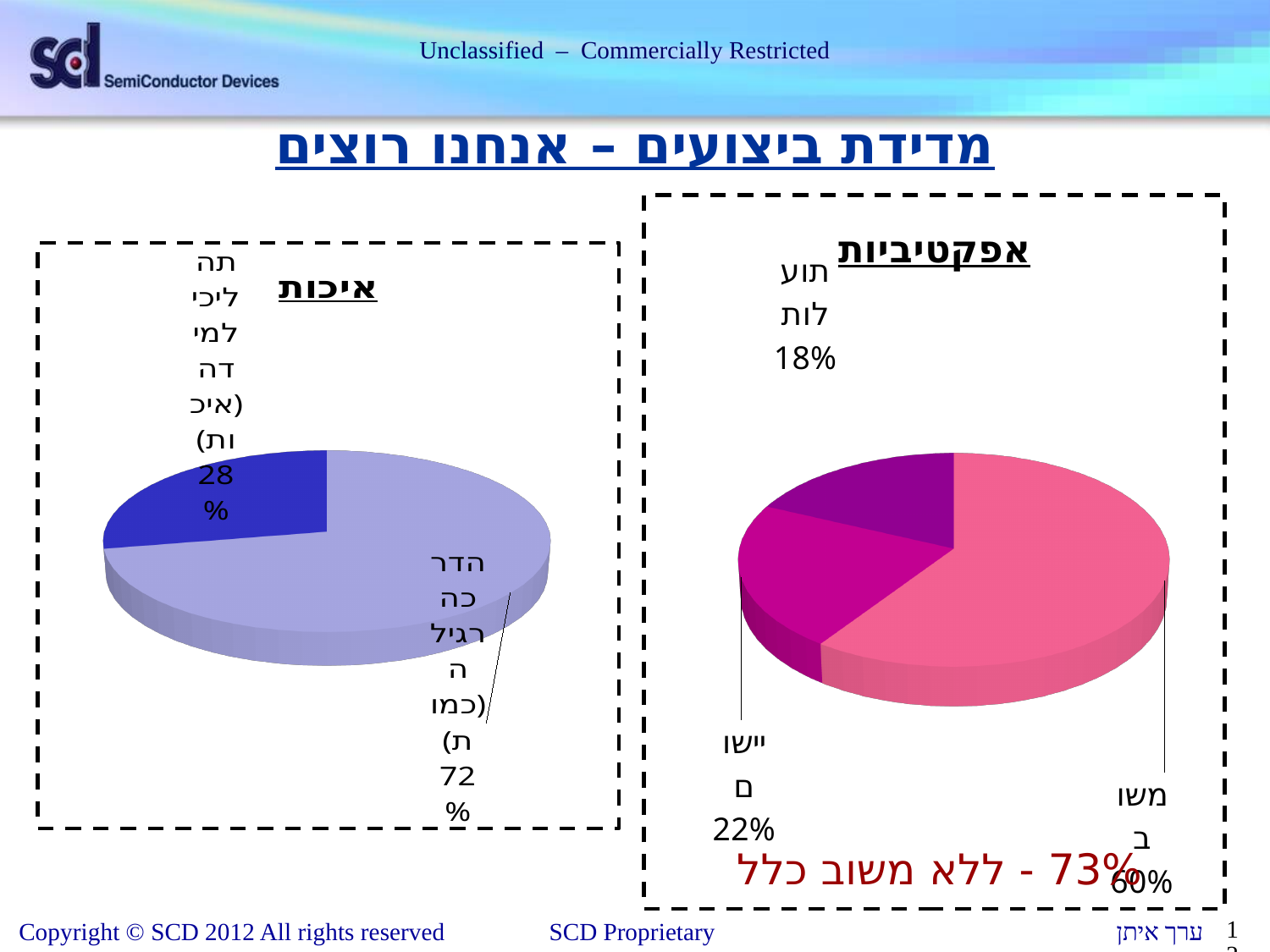
In the chart titled אפקטיביות, what share does the slice labelled יישום have? 22% In the chart titled אפקטיביות, which slice is the smallest? תועלות In the chart titled איכות, what is the difference in percentage points between the הדרכה רגילה (כמות) slice and the תהליכי למידה (איכות) slice? 44 In the chart titled אפקטיביות, what share does the slice labelled משוב have? 60% In the chart titled איכות, how many slices does the pie have? 2 In the chart titled אפקטיביות, what share does the slice labelled תועלות have? 18% How many charts are on the slide? 2 What kind of chart is the chart titled אפקטיביות? pie chart What kind of chart is the chart titled איכות? pie chart In the chart titled אפקטיביות, which slice is the largest? משוב